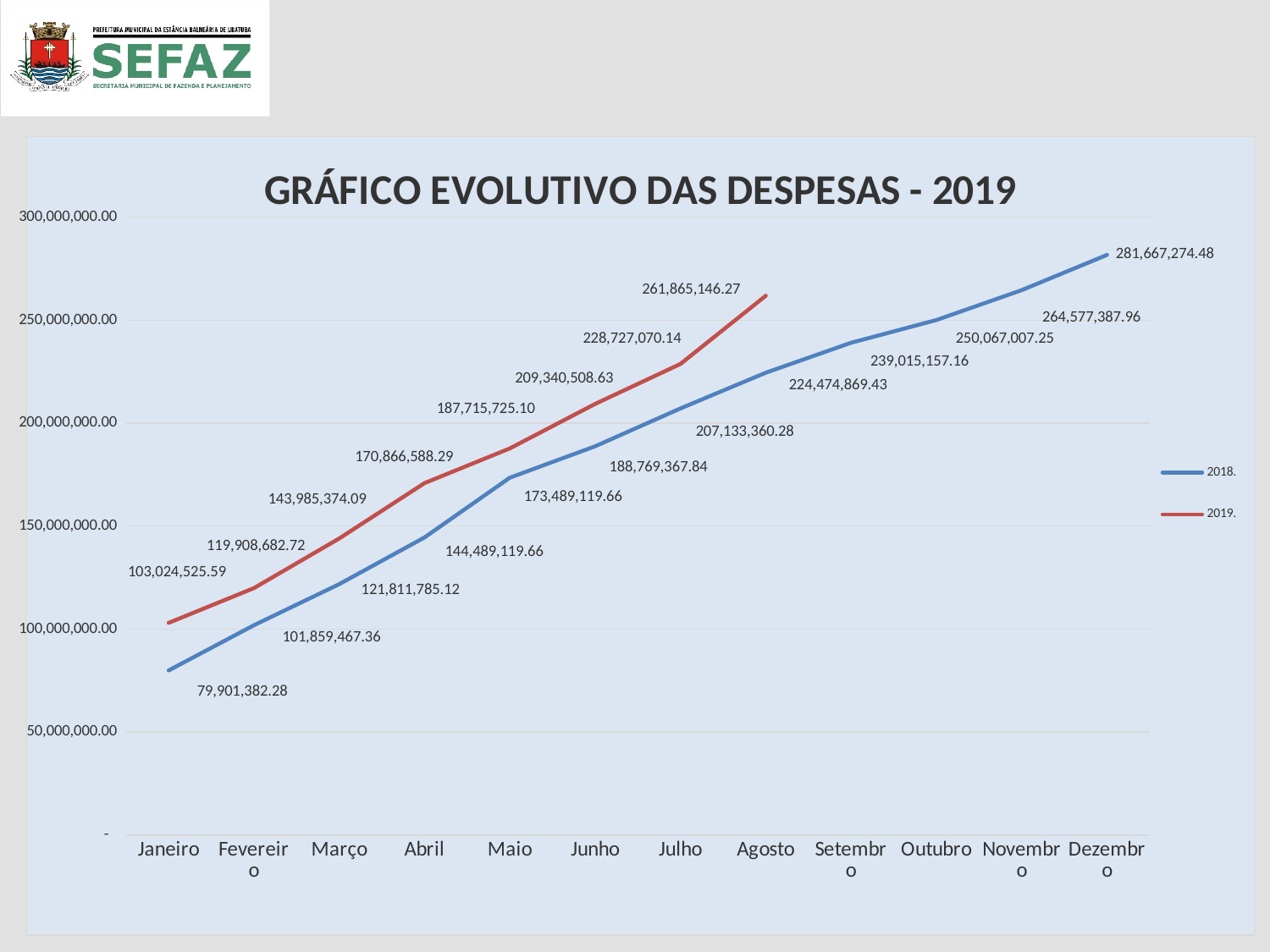
Do the values in the 2018 series rise or fall from Janeiro to Dezembro? Rise Which month has the lowest value in the 2018 series? Janeiro What is the value for Abril in the 2019 series? 170,866,588.29 Which month has the highest value in the 2019 series? Agosto What is the difference between the 2019 and 2018 values for Agosto? 37,390,276.84 What is the value for Janeiro in the 2018 series? 79,901,382.28 What is the value for Dezembro in the 2018 series? 281,667,274.48 Which is larger for Janeiro, the 2018 value or the 2019 value? 2019 How many months are shown on the x axis? 12 How many series does the legend list? 2 What kind of chart is this? Line chart What is the value for Agosto in the 2019 series? 261,865,146.27